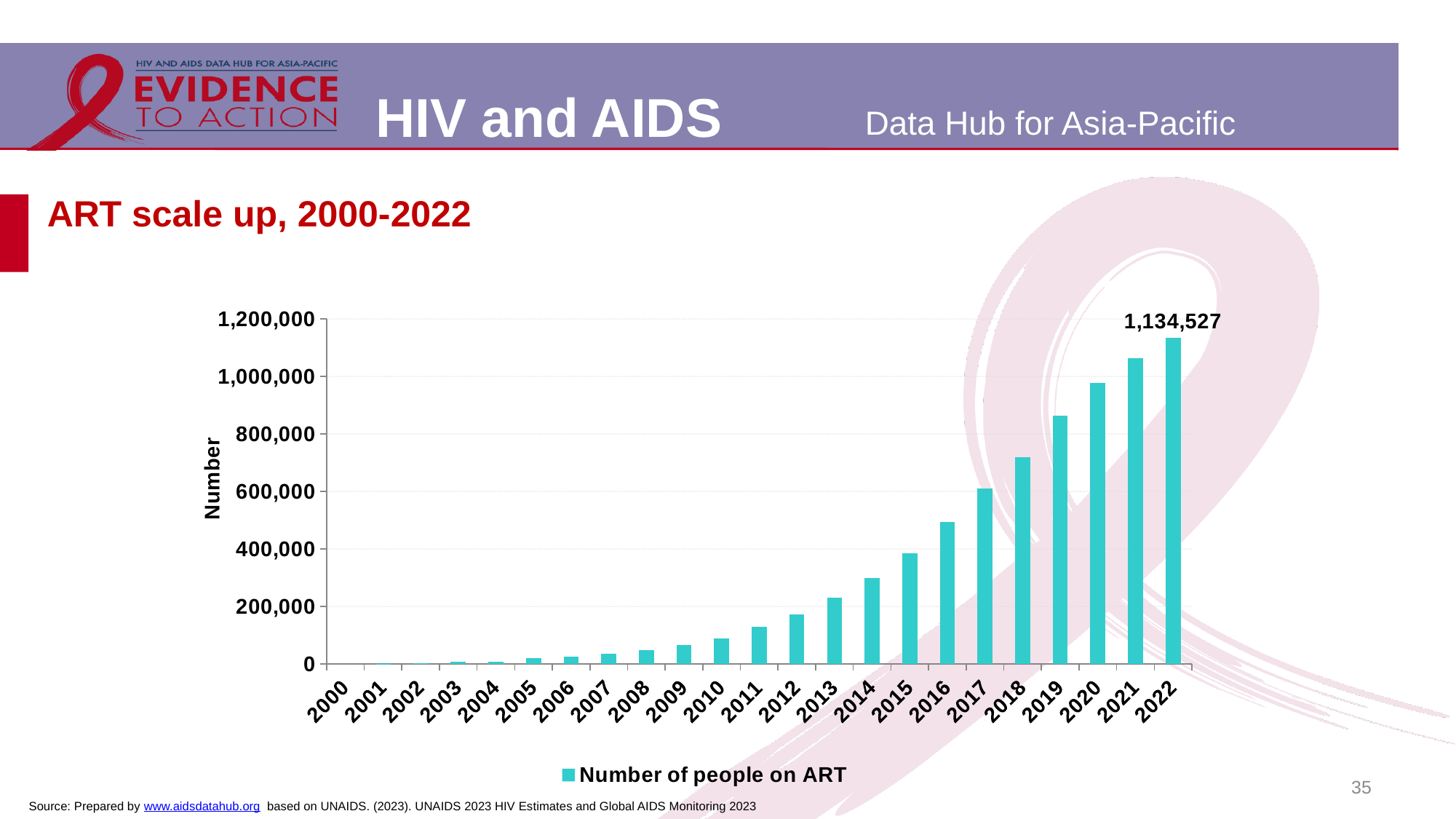
Is the value for 2018 greater or less than 600,000? greater Which year has a larger number of people on ART, 2010 or 2015? 2015 Which year has the highest number of people on ART? 2022 What is the number of people on ART in 2022? 1,134,527 What is the label of the series shown in the legend? Number of people on ART How many series does the legend list? 1 Does the number of people on ART rise or fall from 2000 to 2022? Rise How many years are shown on the x axis of the chart? 23 Is the value for 2021 greater or less than 1,000,000? greater What kind of chart is shown on the slide? Bar chart